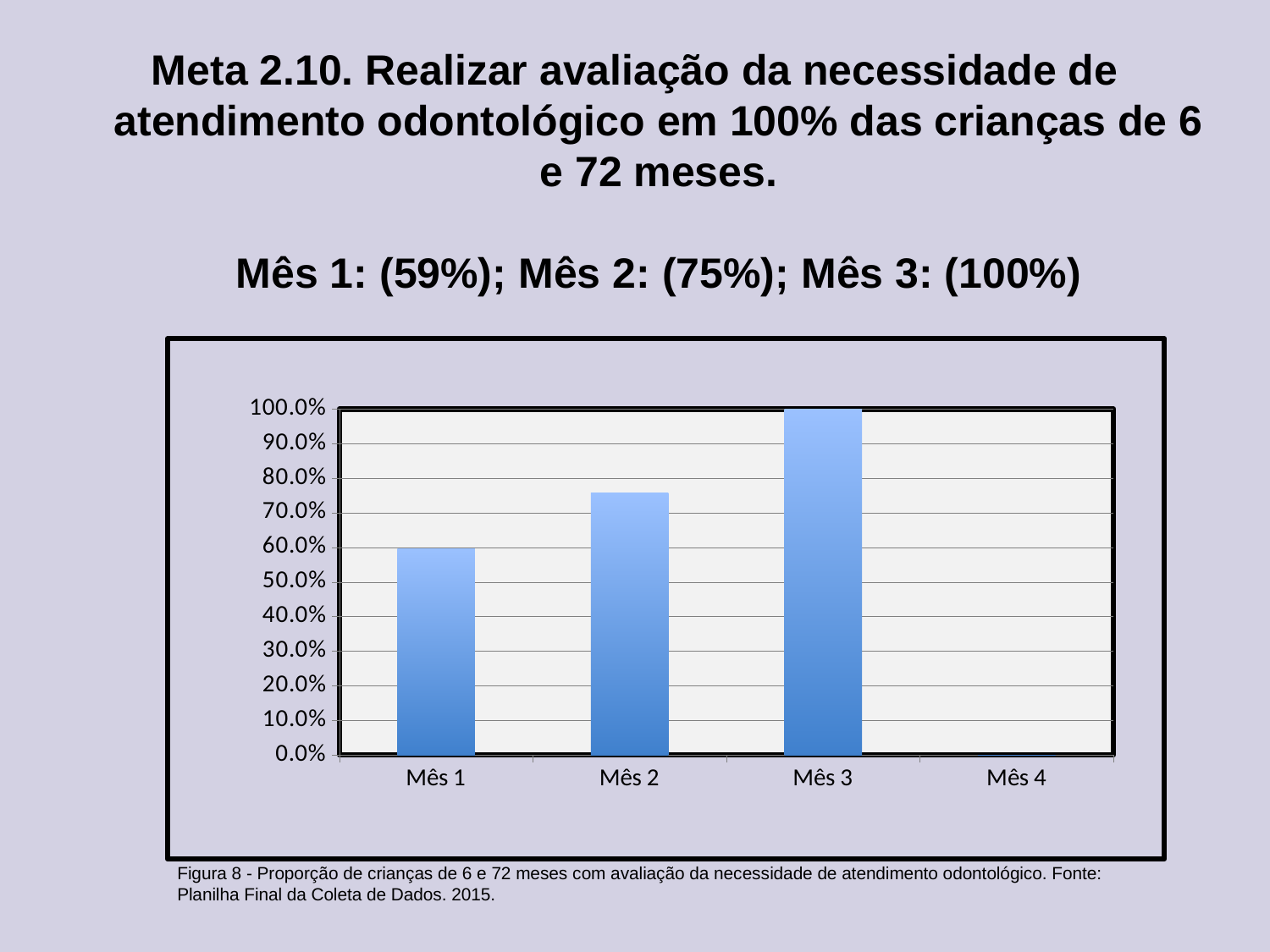
Among Mês 1, Mês 2 and Mês 3, which has the lowest value? Mês 1 What is the figure number given in the caption below the chart? Figura 8 How many categories are shown on the x axis of the chart? 4 Is the value for Mês 1 greater or less than 50.0%? greater Is the value for Mês 1 greater or less than 70.0%? less Do the values rise or fall from Mês 1 to Mês 3? rise Which is larger, the value for Mês 1 or the value for Mês 2? Mês 2 Is the value for Mês 2 greater or less than 70.0%? greater What is the value for Mês 3 in the chart? 100.0% What kind of chart is shown on the slide? bar chart Which month has the highest bar in the chart? Mês 3